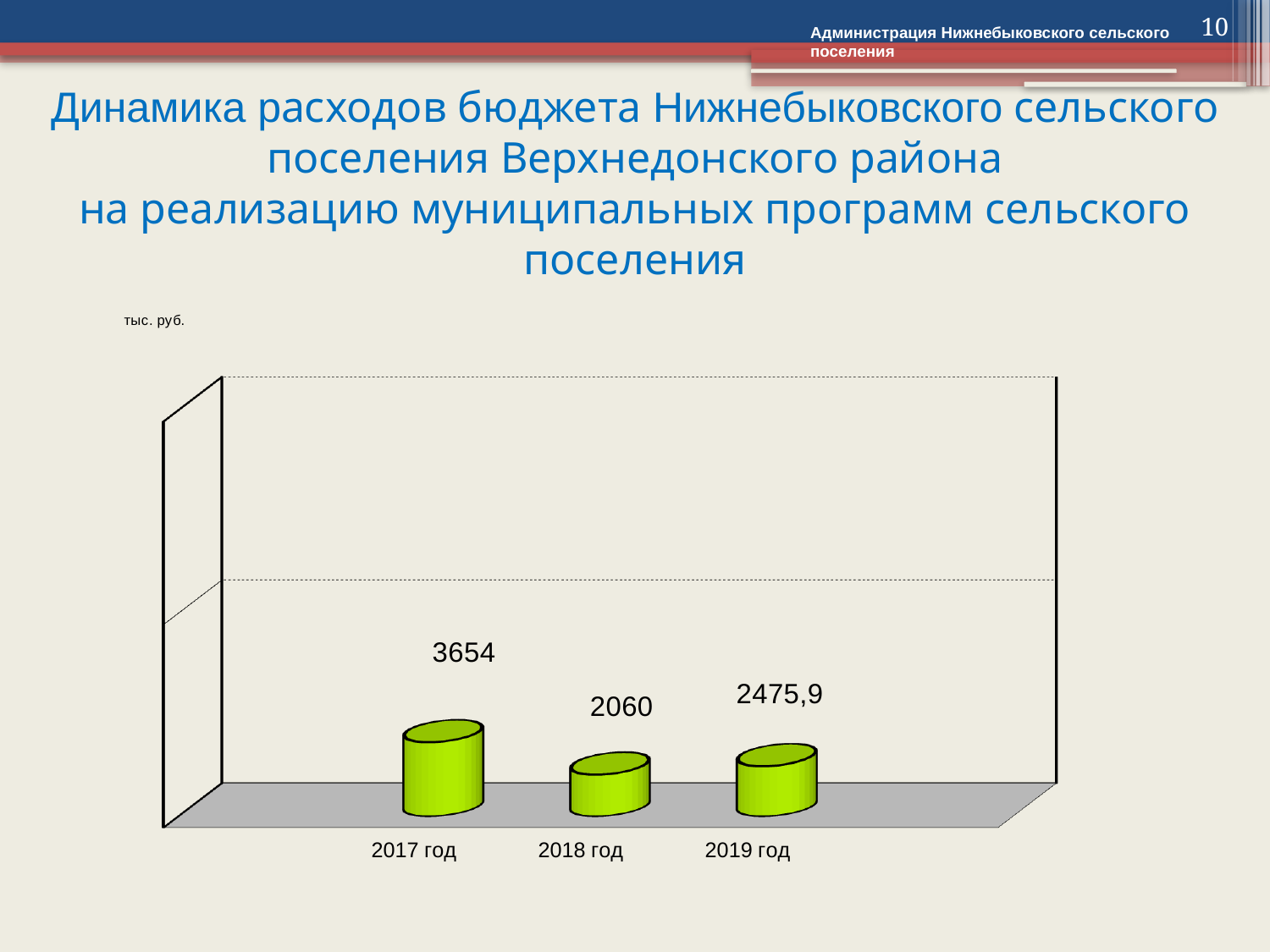
What unit is indicated above the chart? тыс. руб. Which year has the lowest value? 2018 год What is the value for 2017 год? 3654 How many years are shown on the chart? 3 What is the value for 2019 год? 2475,9 Which year has the highest value? 2017 год Does the value rise or fall from 2017 год to 2018 год? fall What kind of chart is shown on the slide? bar chart Which is larger, the value for 2018 год or the value for 2019 год? 2019 год What is the value for 2018 год? 2060 What is the difference between the values for 2017 год and 2018 год? 1594 What is the difference between the values for 2019 год and 2018 год? 415,9